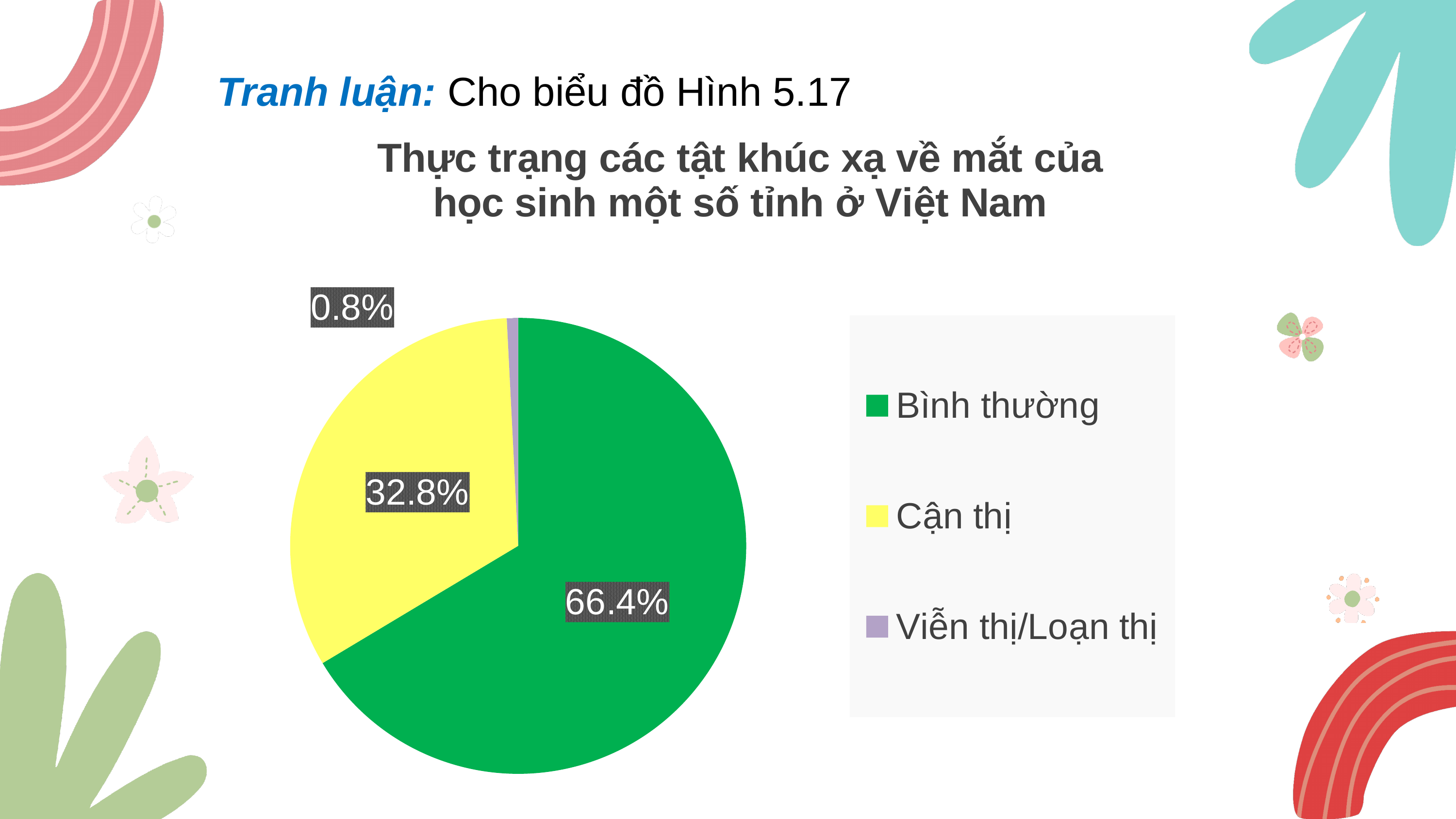
What share of the pie does Bình thường represent? 66.4% What kind of chart is shown on the slide? Pie chart What is the value shown for Viễn thị/Loạn thị? 0.8% What is the value shown for Cận thị? 32.8% What is the difference between the Bình thường and Cận thị percentages? 33.6% Which is larger, the share for Cận thị or the share for Viễn thị/Loạn thị? Cận thị Which category has the largest slice of the pie? Bình thường What is the title of the chart? Thực trạng các tật khúc xạ về mắt của học sinh một số tỉnh ở Việt Nam How many entries does the legend list? 3 How many categories are shown in the pie chart? 3 What colour is the slice for Cận thị? Yellow Which category has the smallest slice of the pie? Viễn thị/Loạn thị